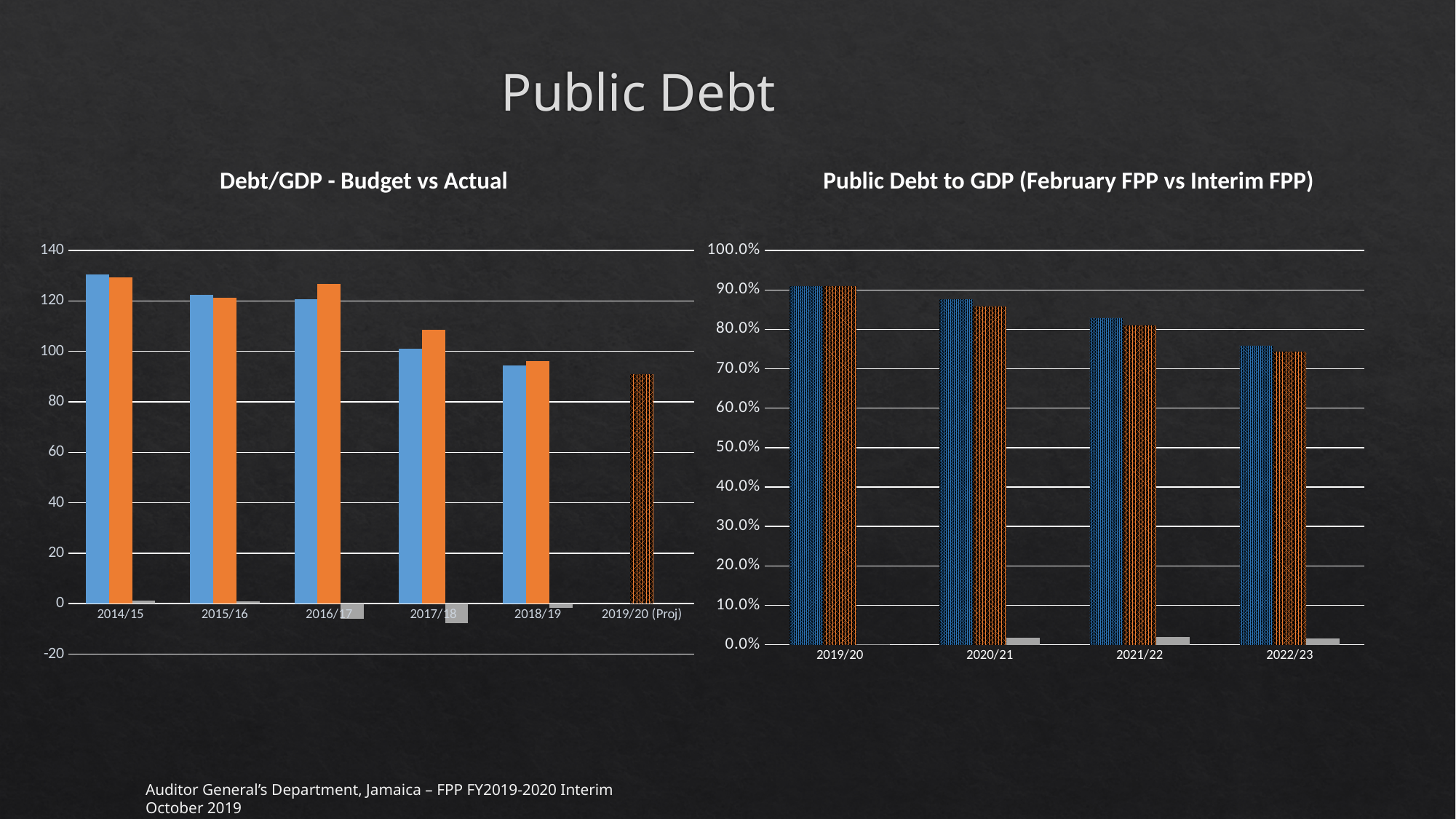
On the 'Public Debt to GDP (February FPP vs Interim FPP)' chart, do the values rise or fall from 2019/20 to 2022/23? fall On the 'Debt/GDP - Budget vs Actual' chart, is the blue bar for 2014/15 greater or less than 120? greater On the 'Debt/GDP - Budget vs Actual' chart, which is larger for 2017/18, the blue bar or the orange bar? the orange bar On the 'Debt/GDP - Budget vs Actual' chart, which is larger for 2016/17, the blue bar or the orange bar? the orange bar What type of chart is the 'Debt/GDP - Budget vs Actual' chart? bar chart On the 'Public Debt to GDP (February FPP vs Interim FPP)' chart, which fiscal year has the highest values? 2019/20 How many fiscal-year categories are shown on the 'Debt/GDP - Budget vs Actual' chart? 6 On the 'Debt/GDP - Budget vs Actual' chart, is the value for 2019/20 (Proj) greater or less than 100? less On the 'Debt/GDP - Budget vs Actual' chart, do the values generally rise or fall from 2014/15 to 2019/20 (Proj)? fall How many fiscal-year categories are shown on the 'Public Debt to GDP (February FPP vs Interim FPP)' chart? 4 On the 'Public Debt to GDP (February FPP vs Interim FPP)' chart, is the blue bar for 2022/23 greater or less than 80.0%? less